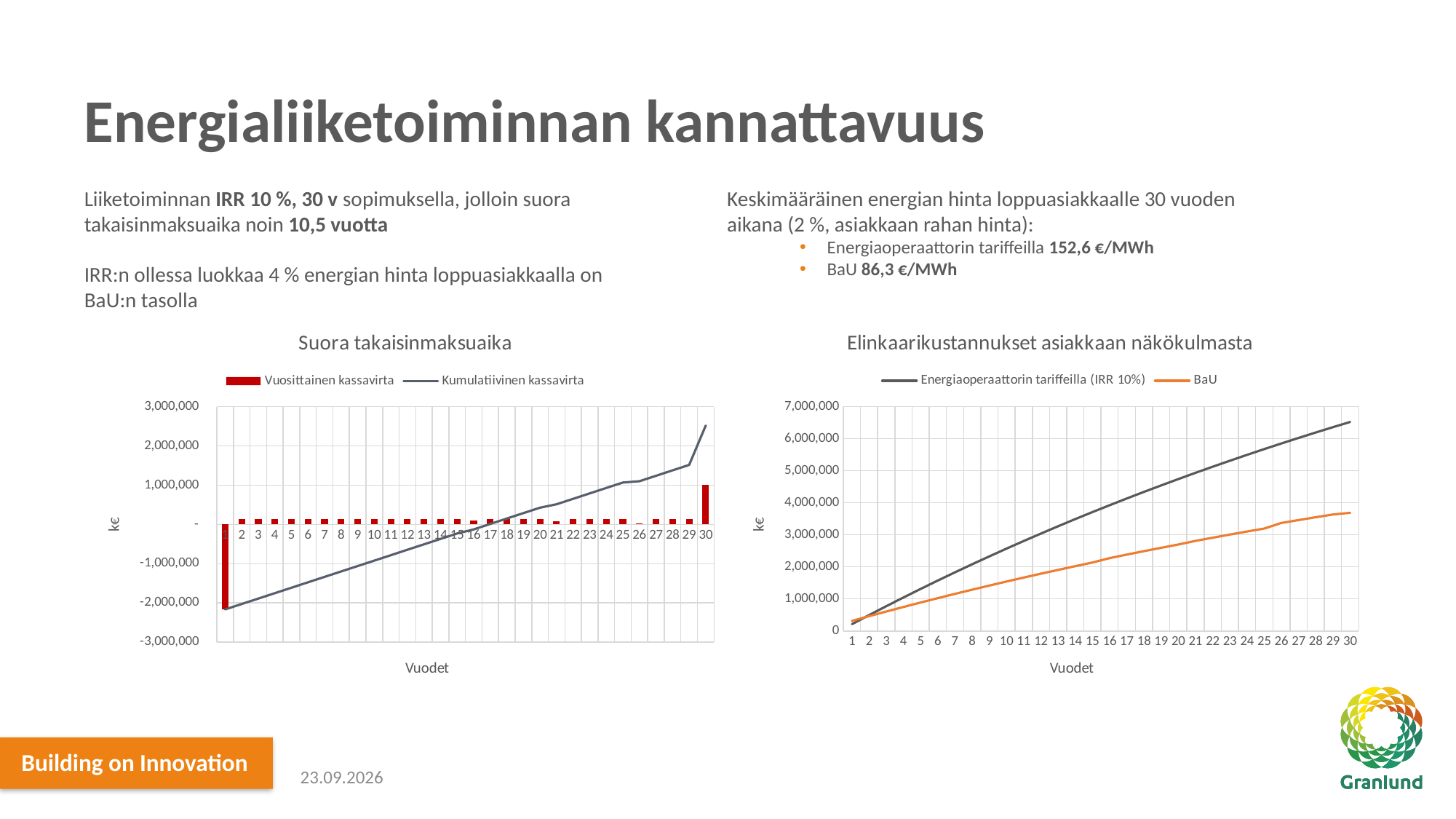
In the 'Elinkaarikustannukset asiakkaan näkökulmasta' chart, which series is higher at year 30, Energiaoperaattorin tariffeilla (IRR 10%) or BaU? Energiaoperaattorin tariffeilla (IRR 10%) What kind of chart is the 'Elinkaarikustannukset asiakkaan näkökulmasta' chart? line chart How many series does the legend of the 'Elinkaarikustannukset asiakkaan näkökulmasta' chart list? 2 What is the x axis label of the 'Elinkaarikustannukset asiakkaan näkökulmasta' chart? Vuodet In the 'Suora takaisinmaksuaika' chart, is the Vuosittainen kassavirta value for year 1 greater or less than -2,000,000? less In the 'Elinkaarikustannukset asiakkaan näkökulmasta' chart, is the Energiaoperaattorin tariffeilla (IRR 10%) value at year 30 greater or less than 6,000,000? greater In the 'Elinkaarikustannukset asiakkaan näkökulmasta' chart, do the BaU values rise or fall along the x axis? rise In the 'Suora takaisinmaksuaika' chart, does the Kumulatiivinen kassavirta line rise or fall from year 1 to year 30? rise In the 'Suora takaisinmaksuaika' chart, is the Kumulatiivinen kassavirta value at year 30 greater or less than 2,000,000? greater How many series does the legend of the 'Suora takaisinmaksuaika' chart list? 2 How many years are shown on the x axis of the 'Suora takaisinmaksuaika' chart? 30